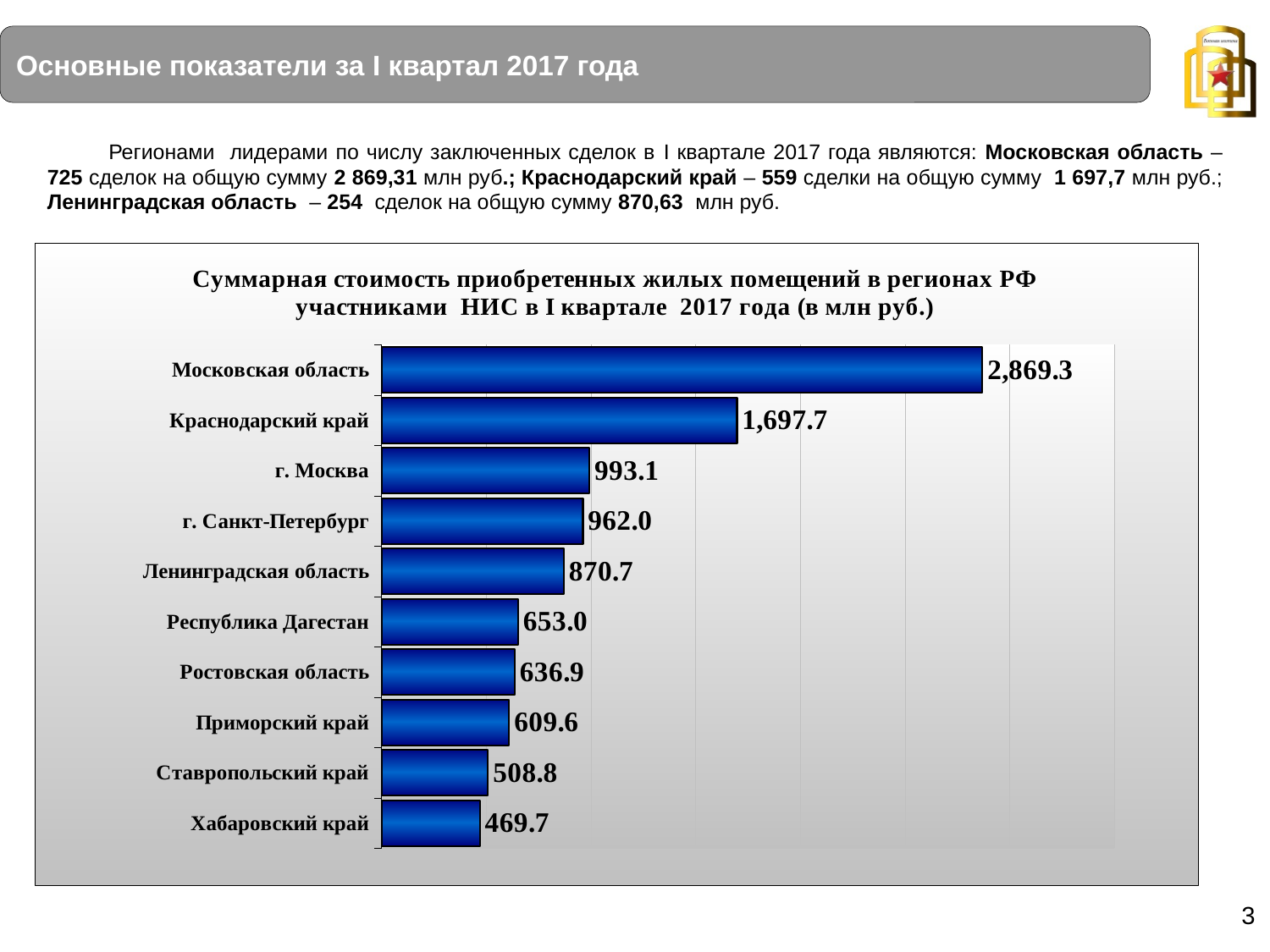
How many regions are shown in the chart? 10 Which region has the highest value? Московская область Which is larger, the value for г. Москва or the value for Ленинградская область? г. Москва Do the values rise or fall going from the top bar to the bottom bar? Fall In what unit are the values in the chart expressed, according to the chart title? млн руб. What is the difference between the values for Московская область and Краснодарский край? 1,171.6 What kind of chart is shown on the slide? Bar chart What is the value for Ставропольский край? 508.8 Which region has the lowest value? Хабаровский край What is the difference between the values for Приморский край and Ставропольский край? 100.8 What is the value for Московская область? 2,869.3 What is the value for г. Санкт-Петербург? 962.0